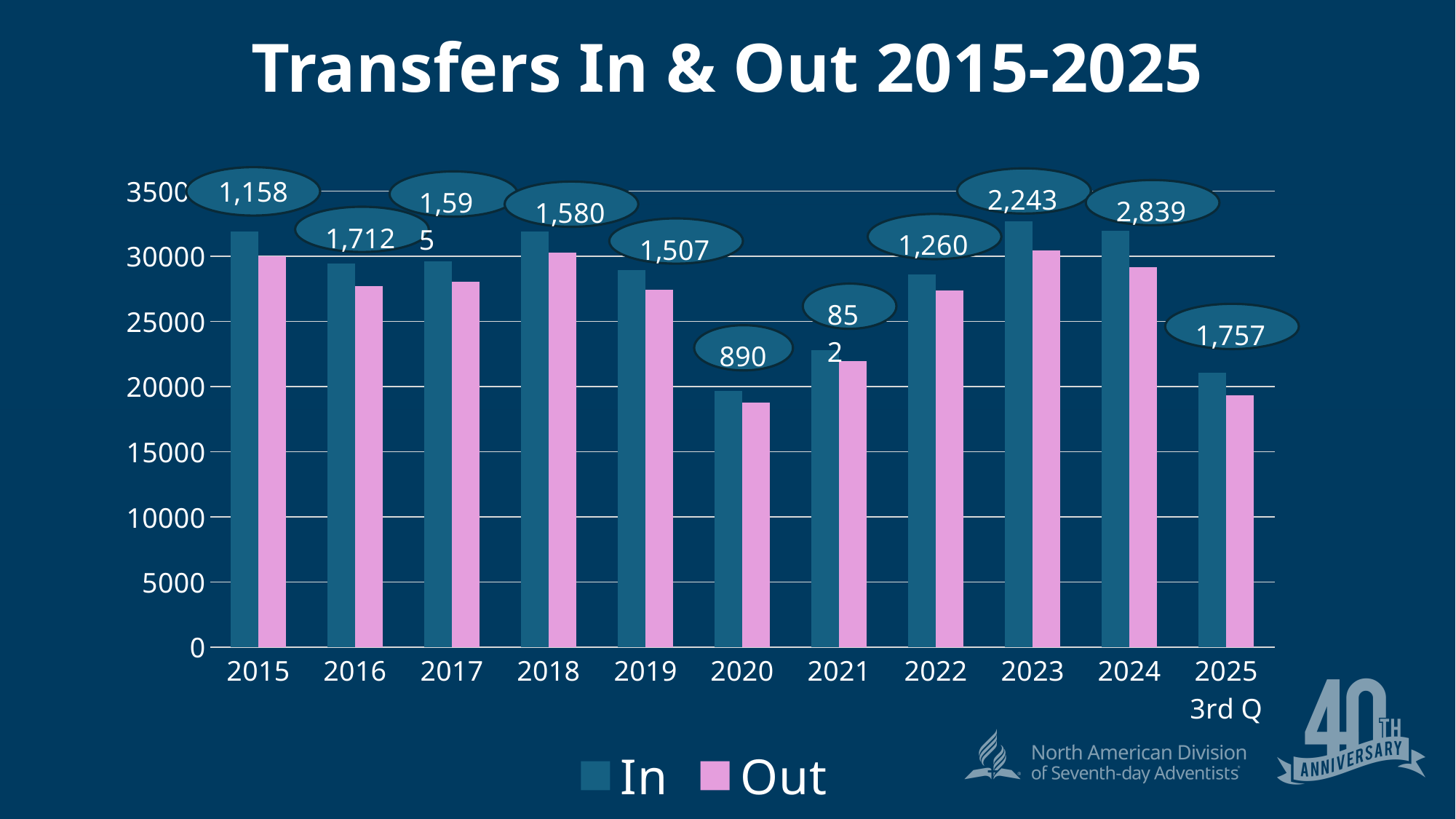
In 2024, which is larger, In or Out? In How many series does the legend list? 2 Which is larger, the In value for 2015 or the In value for 2020? 2015 Is the value for Out in 2020 greater or less than 20000? less How many year categories are shown on the x axis? 11 Which year has the lowest value for the In series? 2020 What kind of chart is shown on the slide? bar chart Is the value for In in 2024 greater or less than 30000? greater Which colour represents the Out series in the legend? pink Is the value for Out in 2025 3rd Q greater or less than 20000? less